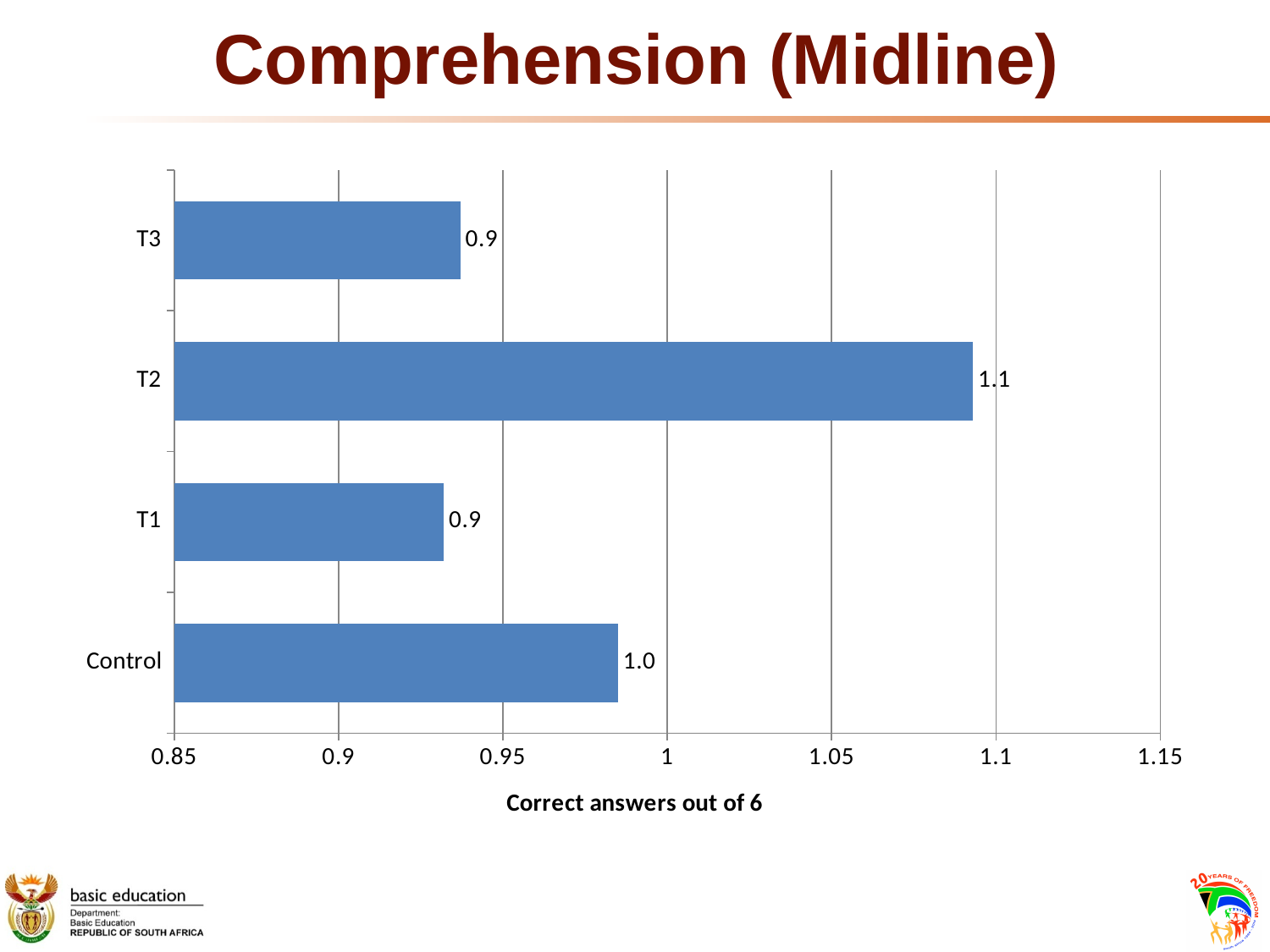
How many categories are shown in the chart? 4 What is the value for T1? 0.9 What is the value for T3? 0.9 Is the value for Control greater or less than 0.95? greater What is the label on the horizontal axis of the chart? Correct answers out of 6 Which is larger, the value for T2 or the value for Control? T2 Which category has the highest value? T2 Is the value for T2 greater or less than 1.05? greater Is the value for T3 greater or less than 0.95? less What is the value for T2? 1.1 What is the value for Control? 1.0 What kind of chart is shown on the slide? Bar chart